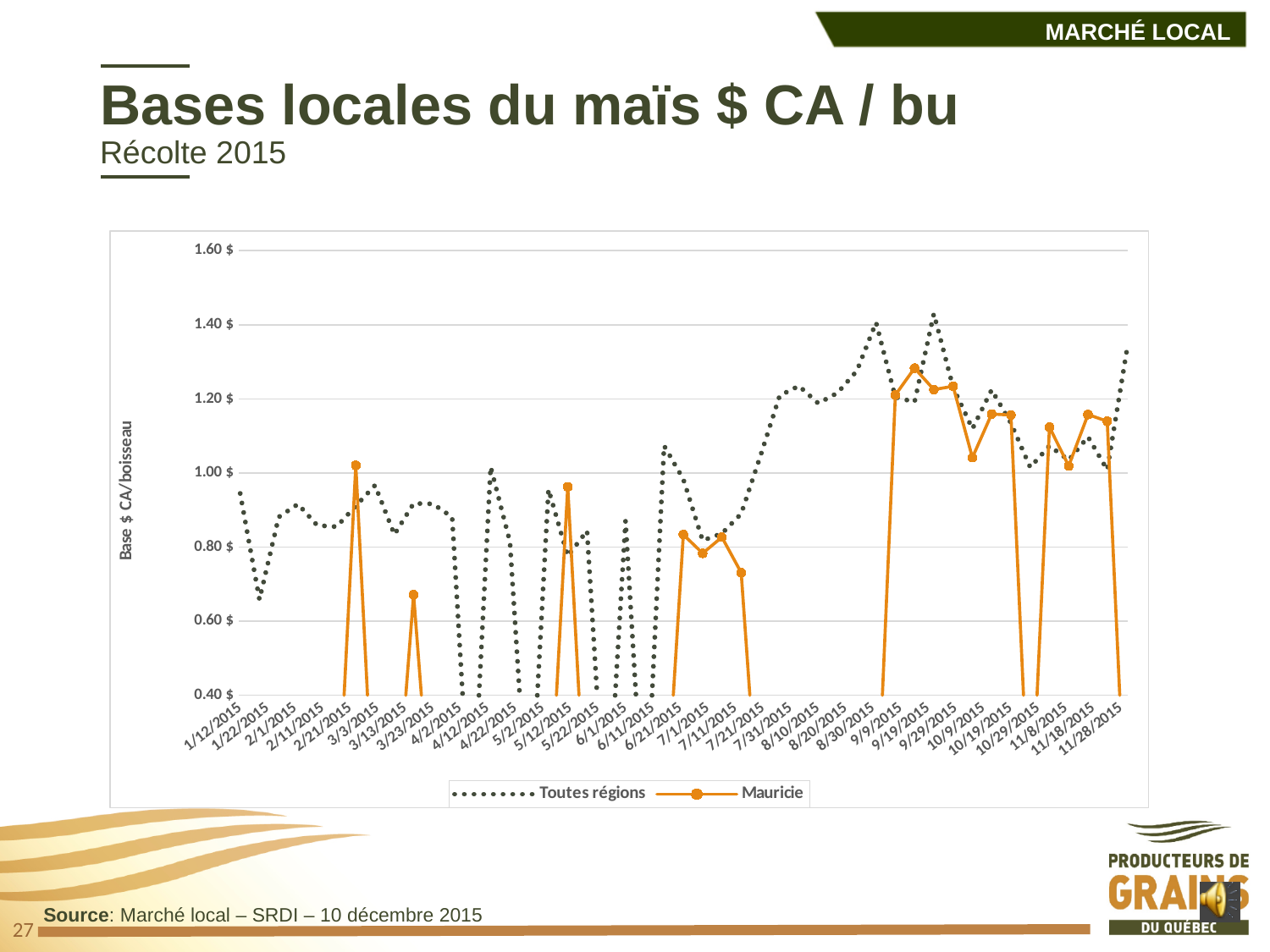
What are the two series named in the legend? Toutes régions and Mauricie How many series does the legend list? 2 At 6/21/2015, which series has the higher value, Toutes régions or Mauricie? Toutes régions Is the Toutes régions value at 1/22/2015 greater or less than 0.80 $? less Is the Mauricie value at 9/19/2015 greater or less than 1.20 $? greater What kind of chart is shown on the slide? Line chart What is the label of the vertical axis? Base $ CA/boisseau Between 7/11/2015 and 8/30/2015, does the Toutes régions series generally rise or fall? Rise Is the Toutes régions value at 11/28/2015 greater or less than 1.20 $? greater